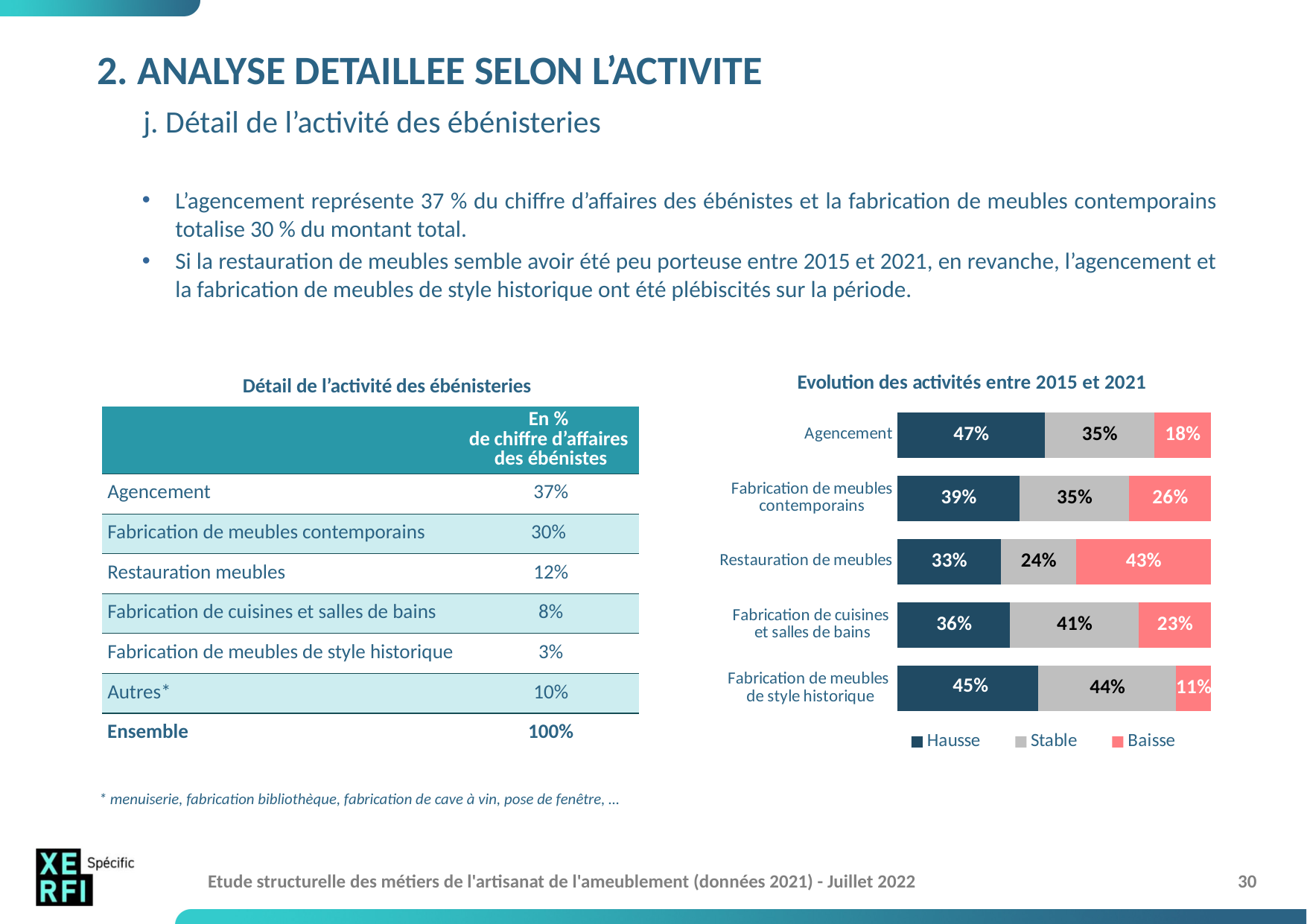
In the chart 'Evolution des activités entre 2015 et 2021', which activity has the highest 'Baisse' value? Restauration de meubles In the chart 'Evolution des activités entre 2015 et 2021', what is the 'Stable' value for Fabrication de cuisines et salles de bains? 41% In the chart 'Evolution des activités entre 2015 et 2021', what is the 'Baisse' value for Fabrication de meubles de style historique? 11% In the chart 'Evolution des activités entre 2015 et 2021', which activity has the lowest 'Baisse' value? Fabrication de meubles de style historique In the chart 'Evolution des activités entre 2015 et 2021', what is the 'Baisse' value for Restauration de meubles? 43% In the chart 'Evolution des activités entre 2015 et 2021', what is the difference between the 'Hausse' value for Agencement and the 'Hausse' value for Restauration de meubles? 14 percentage points In the chart 'Evolution des activités entre 2015 et 2021', is the 'Stable' value larger for Fabrication de meubles de style historique or for Restauration de meubles? Fabrication de meubles de style historique How many activities are shown in the chart 'Evolution des activités entre 2015 et 2021'? 5 What kind of chart is 'Evolution des activités entre 2015 et 2021'? Stacked bar chart In the chart 'Evolution des activités entre 2015 et 2021', what is the 'Hausse' value for Agencement? 47% In the chart 'Evolution des activités entre 2015 et 2021', which activity has the highest 'Hausse' value? Agencement How many series does the legend of the chart 'Evolution des activités entre 2015 et 2021' list? 3